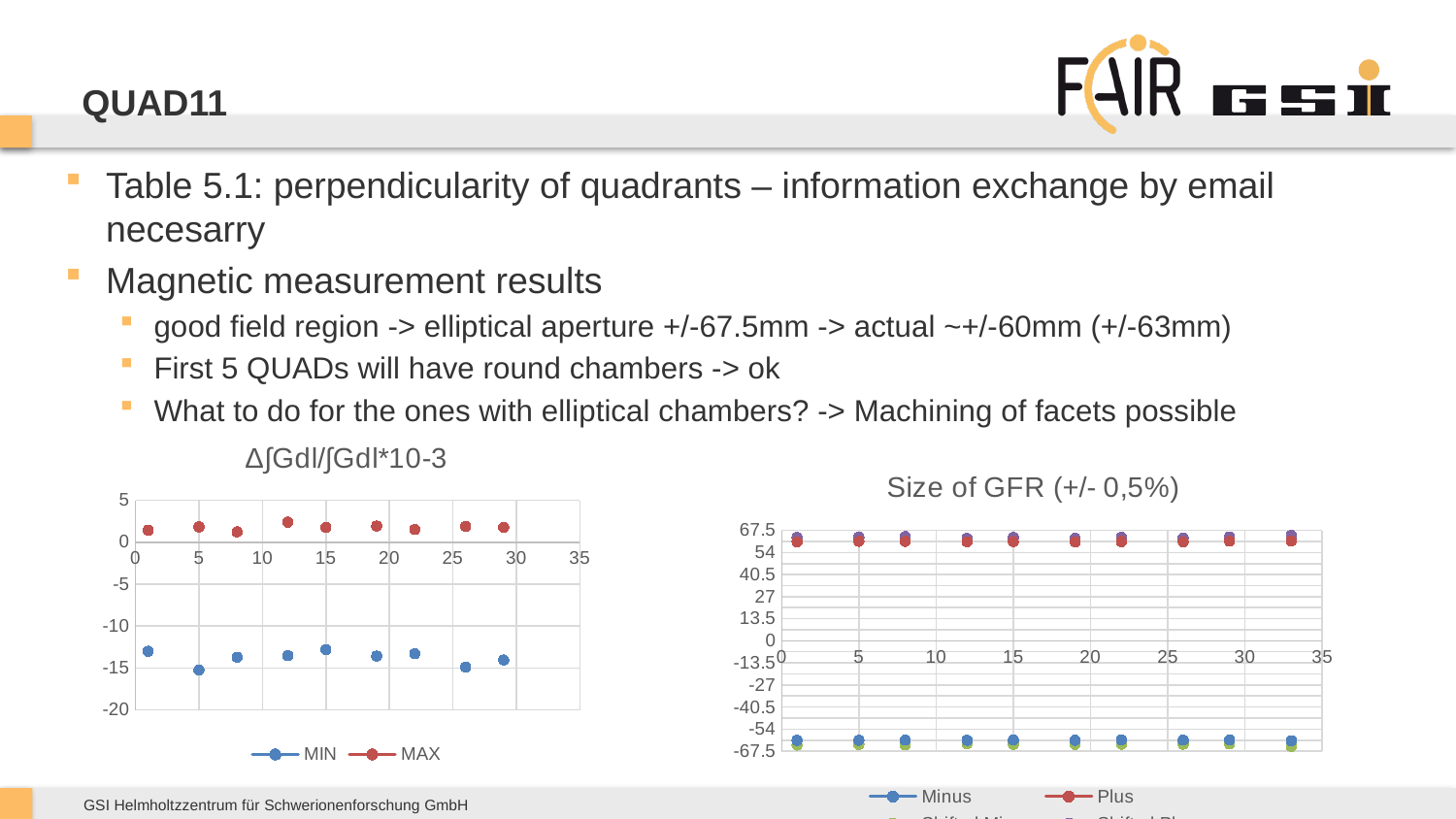
What are the legend entries of the left chart (Δ∫Gdl/∫Gdl*10-3)? MIN and MAX In the right chart (Size of GFR), which series has the larger values, Minus or Plus? Plus What kind of chart is the left chart titled "Δ∫Gdl/∫Gdl*10-3"? scatter chart How many data points does the Plus series have in the right chart (Size of GFR)? 10 In the right chart (Size of GFR), are the Minus values greater or less than -54? less In the left chart (Δ∫Gdl/∫Gdl*10-3), are the MAX values greater or less than 0? greater In the left chart (Δ∫Gdl/∫Gdl*10-3), which series has the larger values, MIN or MAX? MAX How many series does the legend of the left chart (Δ∫Gdl/∫Gdl*10-3) list? 2 What is the title of the right chart? Size of GFR (+/- 0,5%) How many data points does the MIN series have in the left chart (Δ∫Gdl/∫Gdl*10-3)? 9 In the left chart (Δ∫Gdl/∫Gdl*10-3), are the MIN values greater or less than -10? less